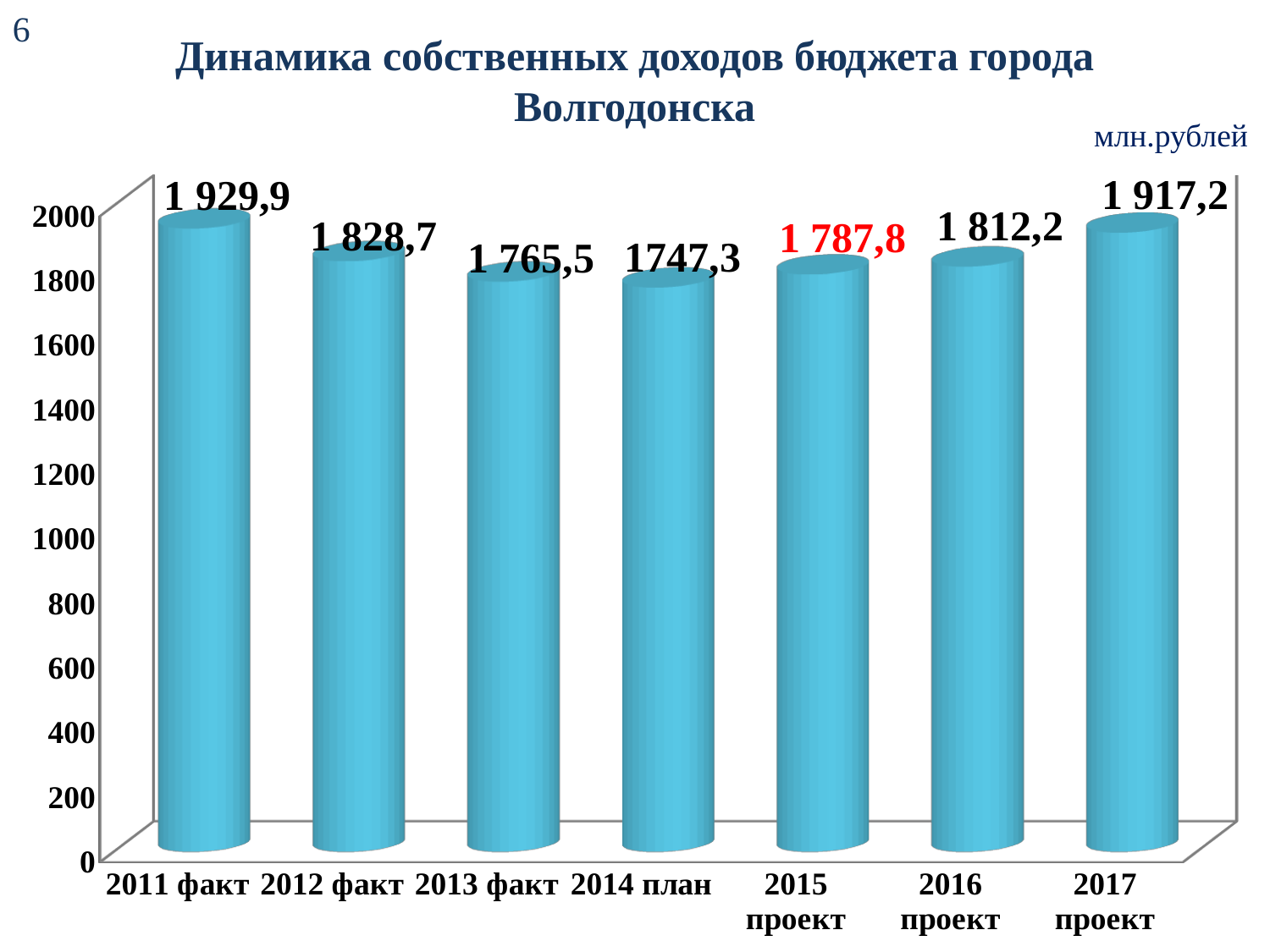
Do the values rise or fall from 2014 план to 2017 проект? Rise What kind of chart is shown on the slide? Bar chart What is the value for 2011 факт? 1 929,9 How many categories are shown on the x axis? 7 What is the value for 2014 план? 1747,3 What is the difference between the values for 2016 проект and 2015 проект? 24,4 Which category has the lowest value? 2014 план What is the value for 2015 проект? 1 787,8 What is the difference between the values for 2011 факт and 2017 проект? 12,7 Which category has the highest value? 2011 факт What is the value for 2017 проект? 1 917,2 Which is larger, the value for 2012 факт or the value for 2016 проект? 2012 факт